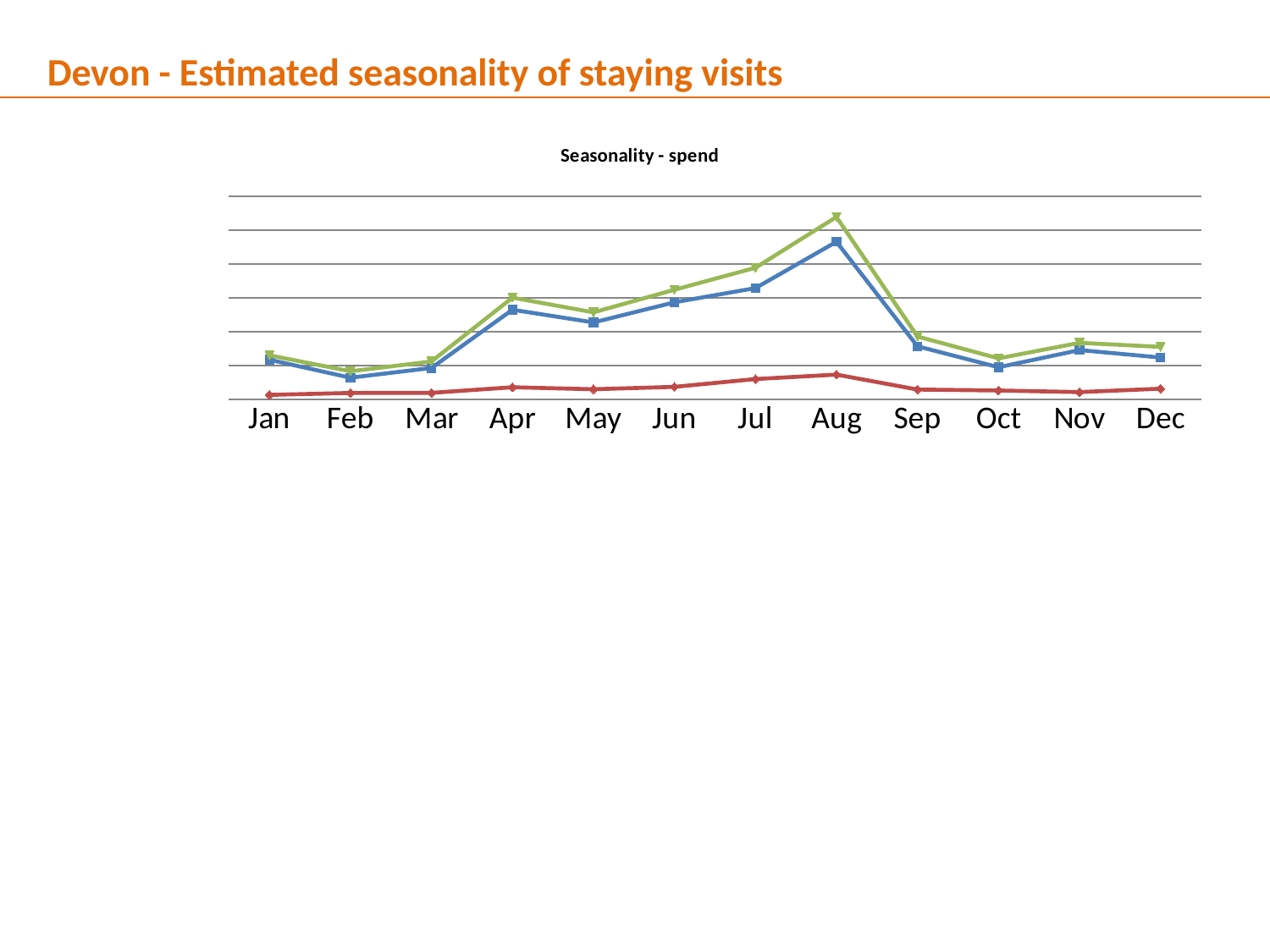
Does the blue line rise or fall from Aug to Sep? fall In which month does the green line reach its highest value? Aug How many lines are plotted on the chart? 3 Does the green line rise or fall from Mar to Apr? rise For the green line, which month has the larger value, Apr or May? Apr In which month is the blue line at its lowest value? Feb For the blue line, which month has the larger value, Sep or Oct? Sep What kind of chart is shown on the slide? line chart How many months are shown along the x axis of the chart? 12 What is the title of the chart? Seasonality - spend In which month is the green line at its lowest value? Feb In which month does the blue line reach its highest value? Aug